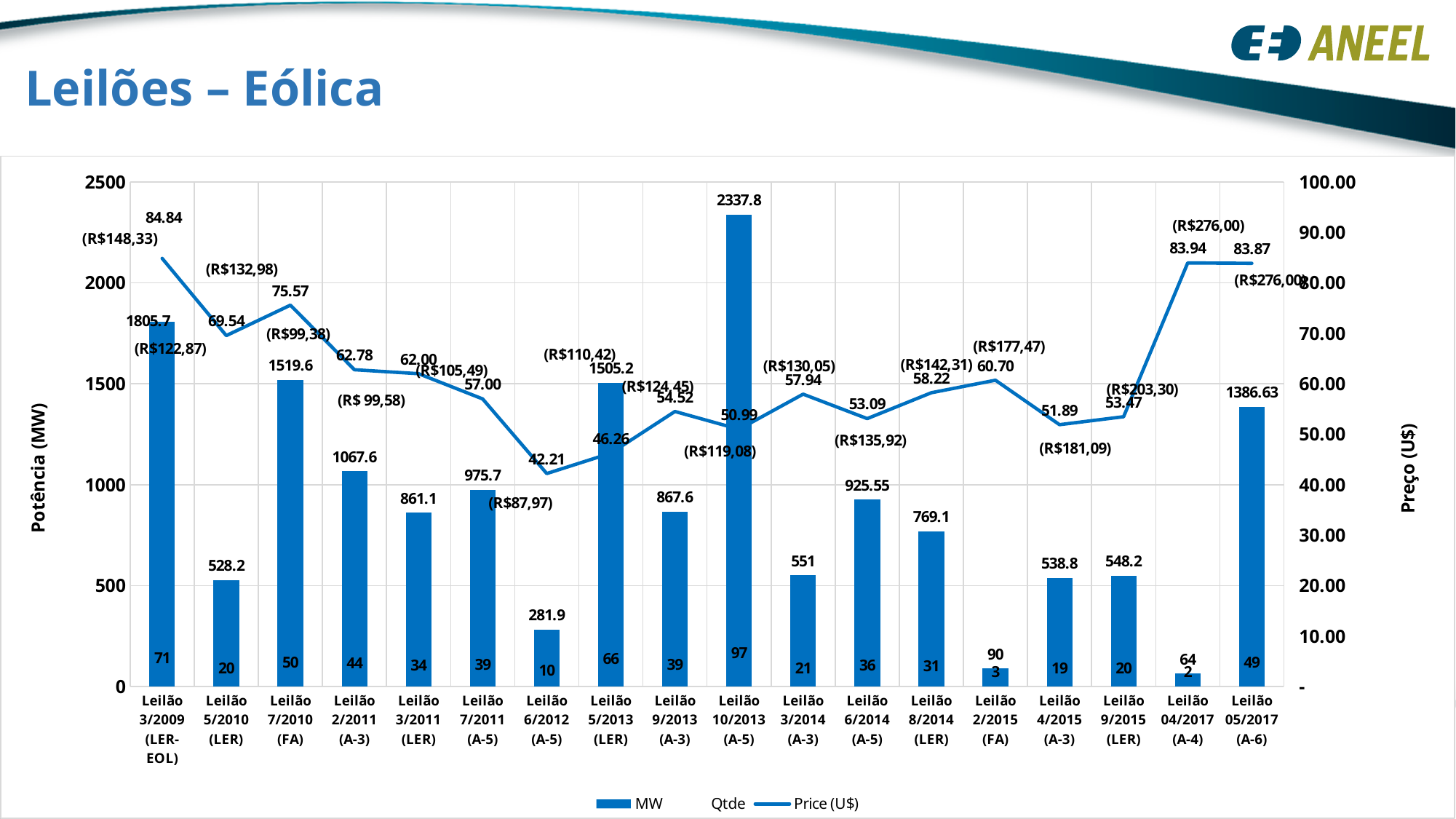
What is the Qtde value shown inside the bar for Leilão 10/2013 (A-5)? 97 Which auction has the highest MW value? Leilão 10/2013 (A-5) What is the Price (U$) value for Leilão 6/2012 (A-5)? 42.21 Is the MW value for Leilão 2/2011 (A-3) greater or less than 1000? greater Which auction has the lowest MW value? Leilão 04/2017 (A-4) Which has the larger MW value, Leilão 3/2011 (LER) or Leilão 7/2011 (A-5)? Leilão 7/2011 (A-5) What kind of chart is shown on the slide? Combined bar and line chart What is the MW value for Leilão 10/2013 (A-5)? 2337.8 How many auctions are shown on the x axis? 18 Which auction has the lowest Price (U$) value on the line? Leilão 6/2012 (A-5) How many series does the legend list? 3 What is the difference in MW between Leilão 3/2009 (LER-EOL) and Leilão 7/2010 (FA)? 286.1